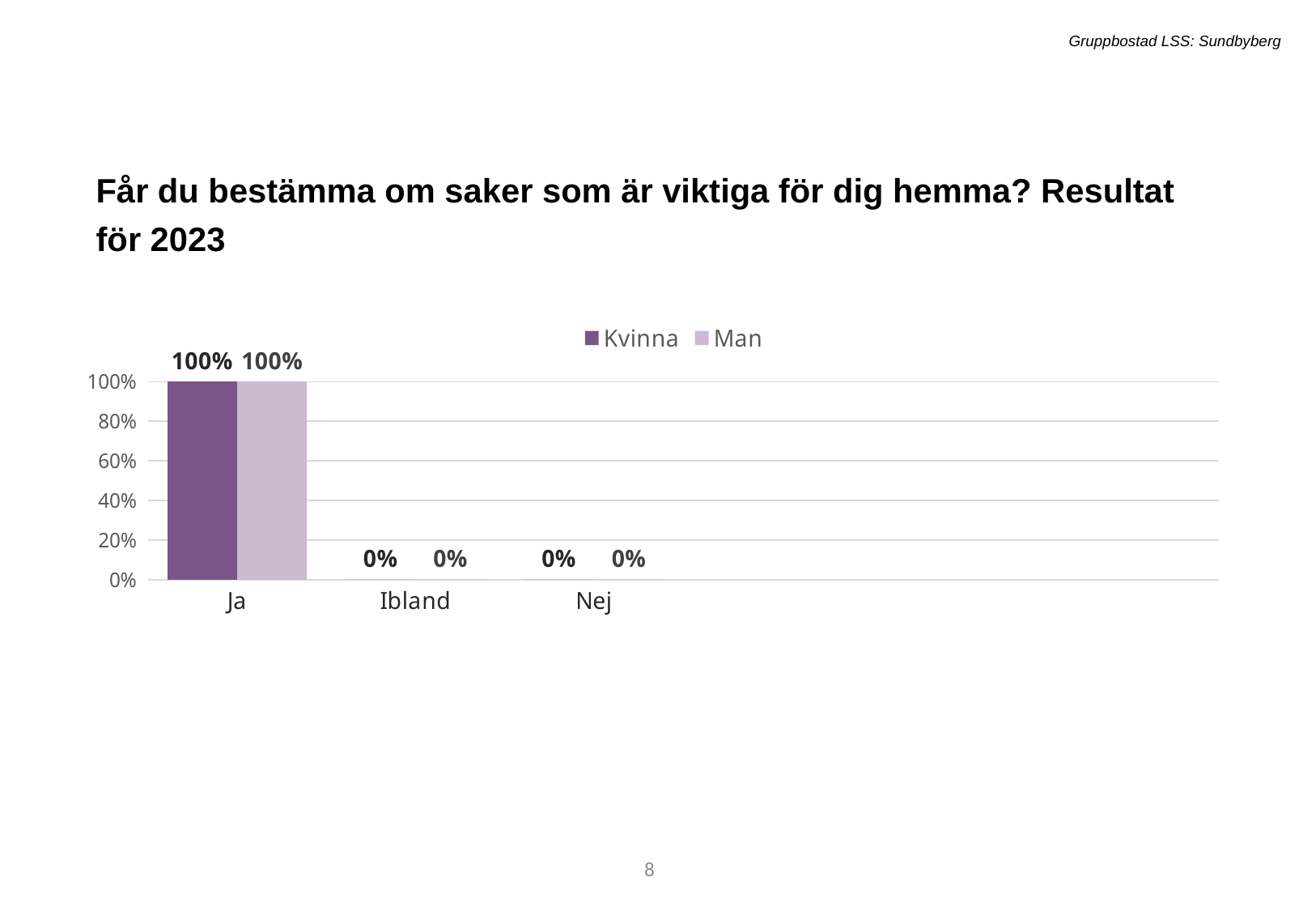
What is the difference between the Kvinna values for Ja and Nej? 100% What is the value for Kvinna in the Ibland category? 0% How many series does the legend list? 2 Which is larger for Man: the value for Ja or the value for Ibland? Ja What is the value for Man in the Nej category? 0% What kind of chart is shown on the slide? Bar chart What is the value for Kvinna in the Ja category? 100% What are the two series named in the legend? Kvinna and Man How many categories are shown on the x axis? 3 Which category has the highest value for Kvinna? Ja What is the value for Man in the Ja category? 100% Do the Kvinna values rise or fall from Ja to Nej along the x axis? Fall